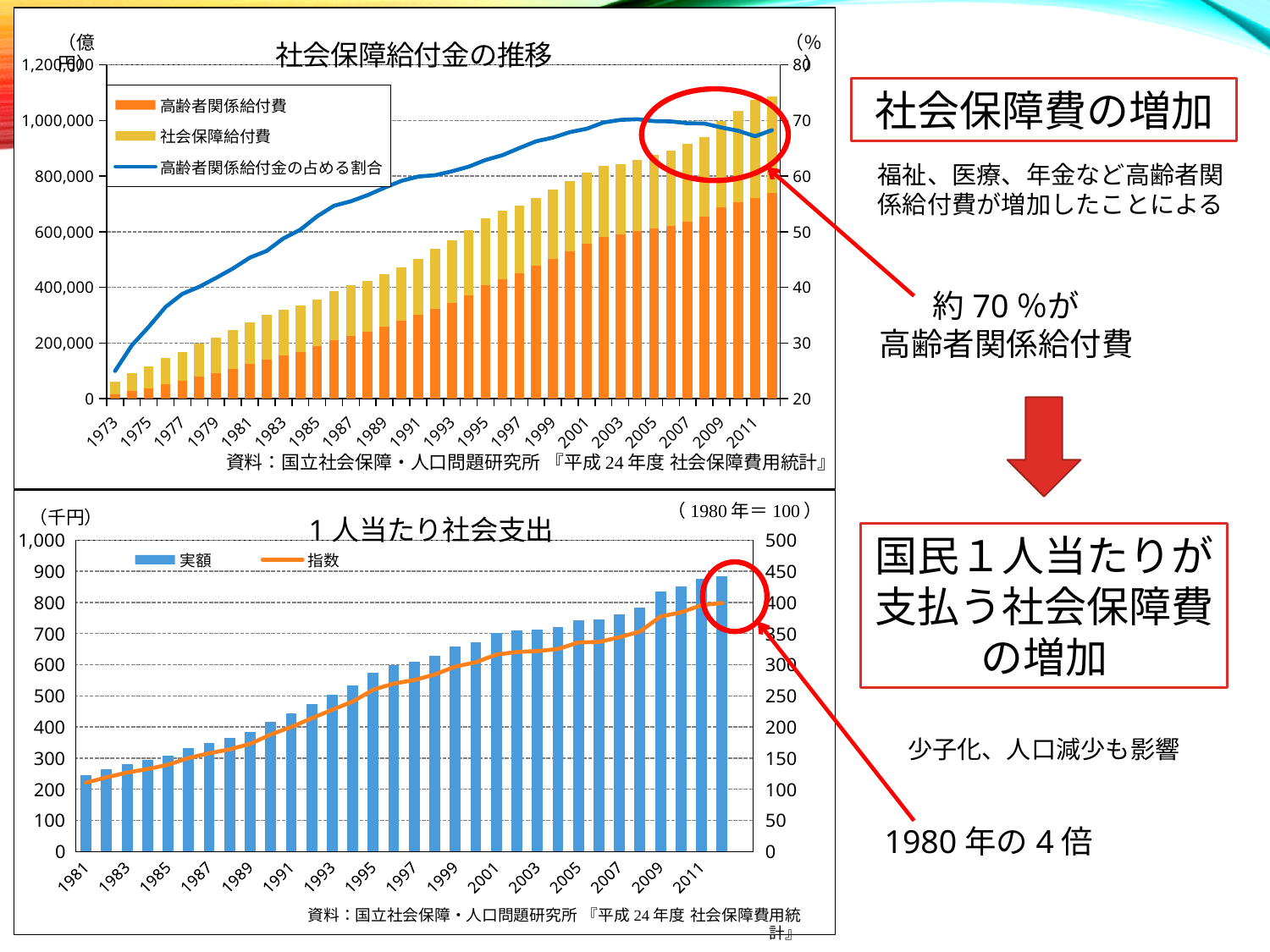
How many series does the legend of the top chart (社会保障給付金の推移) list? 3 How many series does the legend of the bottom chart (1人当たり社会支出) list? 2 In the top chart (社会保障給付金の推移), is the total stacked bar for 2012 greater or less than 1,000,000? greater What type of chart is the bottom chart titled 1人当たり社会支出? A bar chart combined with a line chart In the bottom chart (1人当たり社会支出), what colour are the 実額 bars? Blue In the bottom chart (1人当たり社会支出), which year has the lowest 実額 bar? 1981 In the top chart (社会保障給付金の推移), do the stacked bar totals generally rise or fall from 1973 to 2012? rise In the top chart (社会保障給付金の推移), is the total stacked bar for 1995 larger or smaller than the one for 1985? larger What type of chart is the top chart titled 社会保障給付金の推移? A stacked bar chart combined with a line chart In the top chart (社会保障給付金の推移), which year has the highest total stacked bar? 2012 In the bottom chart (1人当たり社会支出), is the 実額 bar for 2012 greater or less than 800? greater In the top chart (社会保障給付金の推移), is the 高齢者関係給付金の占める割合 line value for 1973 greater or less than 30? less